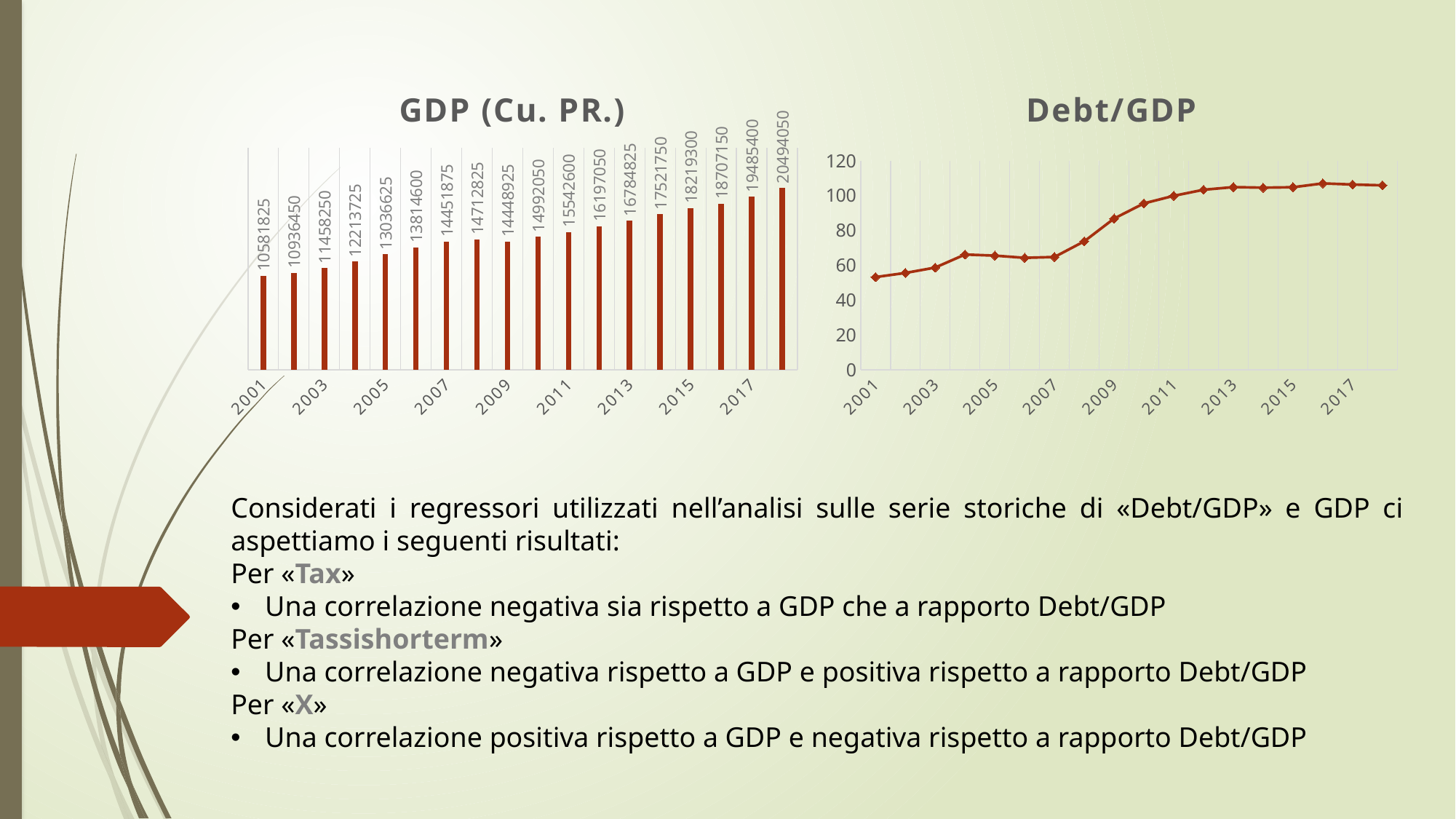
In the Debt/GDP chart, is the value for 2001 greater or less than 60? less In the GDP (Cu. PR.) chart, what is the value for 2001? 10581825 In the GDP (Cu. PR.) chart, what is the value for 2018? 20494050 In the GDP (Cu. PR.) chart, which year has the lowest value? 2001 In the GDP (Cu. PR.) chart, what is the value for 2009? 14448925 What kind of chart is the GDP (Cu. PR.) chart? bar chart In the Debt/GDP chart, is the value for 2013 greater or less than 100? greater In the GDP (Cu. PR.) chart, which is larger, the value for 2008 or the value for 2009? 2008 In the GDP (Cu. PR.) chart, what is the difference between the values for 2018 and 2001? 9912225 How many bars are plotted in the GDP (Cu. PR.) chart? 18 What kind of chart is the Debt/GDP chart? line chart In the GDP (Cu. PR.) chart, which year has the highest value? 2018